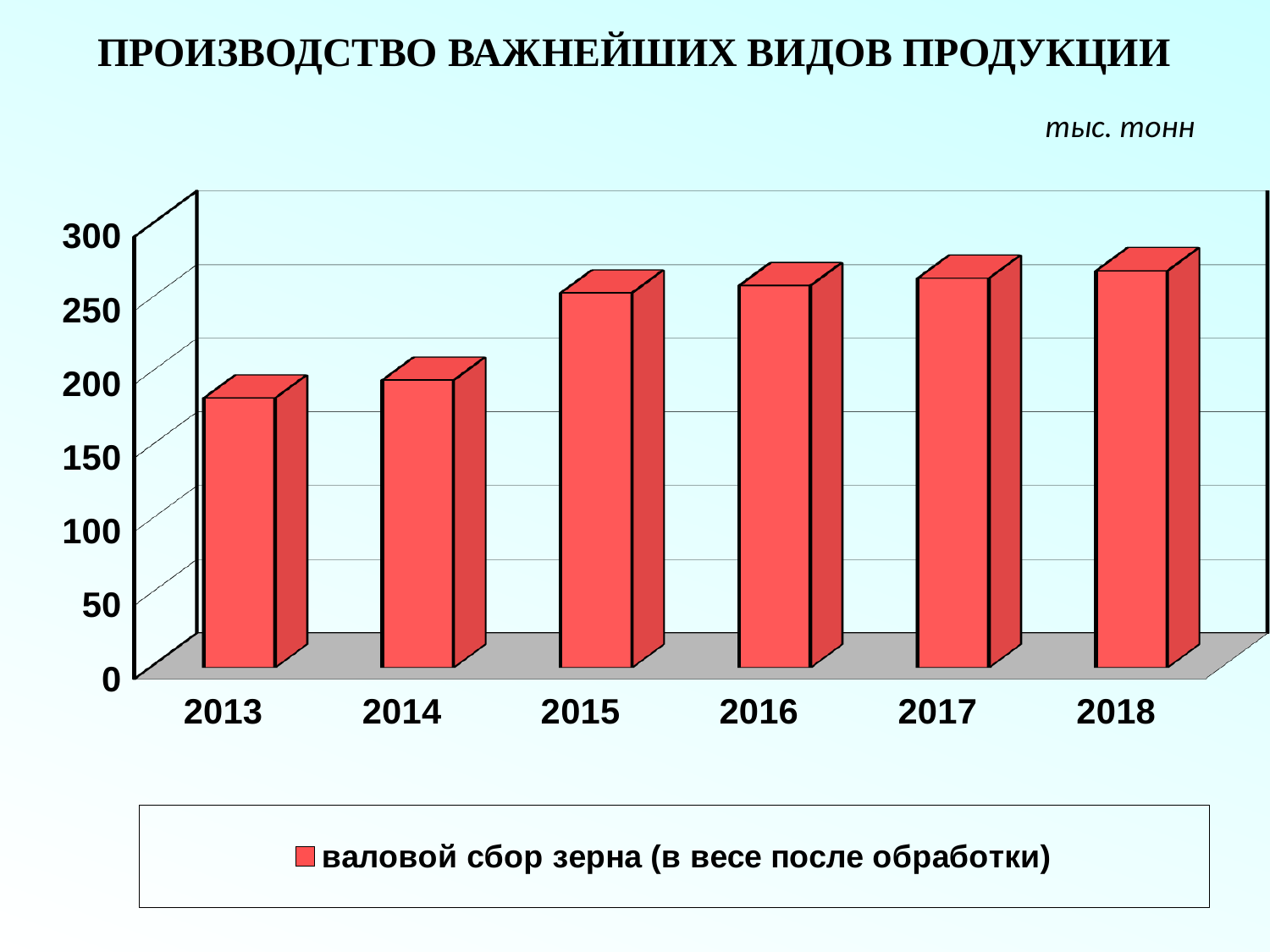
How many series does the legend list? 1 What unit is indicated above the chart? тыс. тонн Do the values generally rise or fall from 2013 to 2018? rise Which year has the lowest value in the chart? 2013 Is the value for 2013 greater or less than 150? greater What kind of chart is shown on the slide? bar chart Is the value for 2013 greater or less than 200? less Is the value for 2018 greater or less than 300? less Which is larger, the value for 2013 or the value for 2015? 2015 How many years are shown on the x axis of the chart? 6